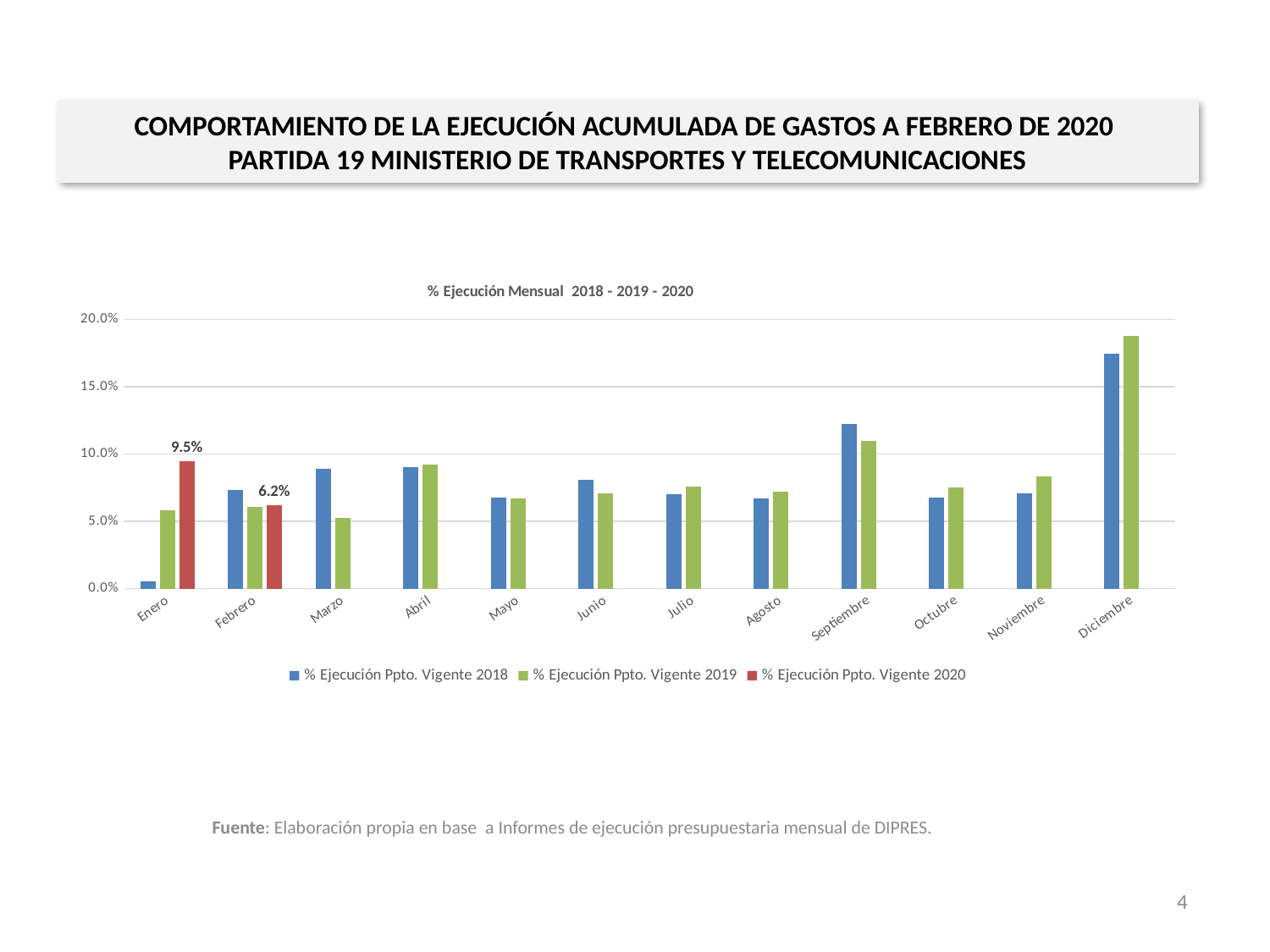
For the 2020 series, which month has the larger value, Enero or Febrero? Enero Which month has the highest value for % Ejecución Ppto. Vigente 2019? Diciembre How many series does the legend list? 3 What is the value for % Ejecución Ppto. Vigente 2020 in Enero? 9.5% Which month has the lowest value for % Ejecución Ppto. Vigente 2018? Enero How many months are shown on the x axis? 12 What is the title of the chart? % Ejecución Mensual 2018 - 2019 - 2020 Is the value for % Ejecución Ppto. Vigente 2018 in Diciembre greater or less than 15.0%? greater Is the value for % Ejecución Ppto. Vigente 2019 in Marzo greater or less than 10.0%? less By how many percentage points does the 2020 value for Enero exceed the 2020 value for Febrero? 3.3 percentage points What is the value for % Ejecución Ppto. Vigente 2020 in Febrero? 6.2% What kind of chart is shown on the slide? Bar chart